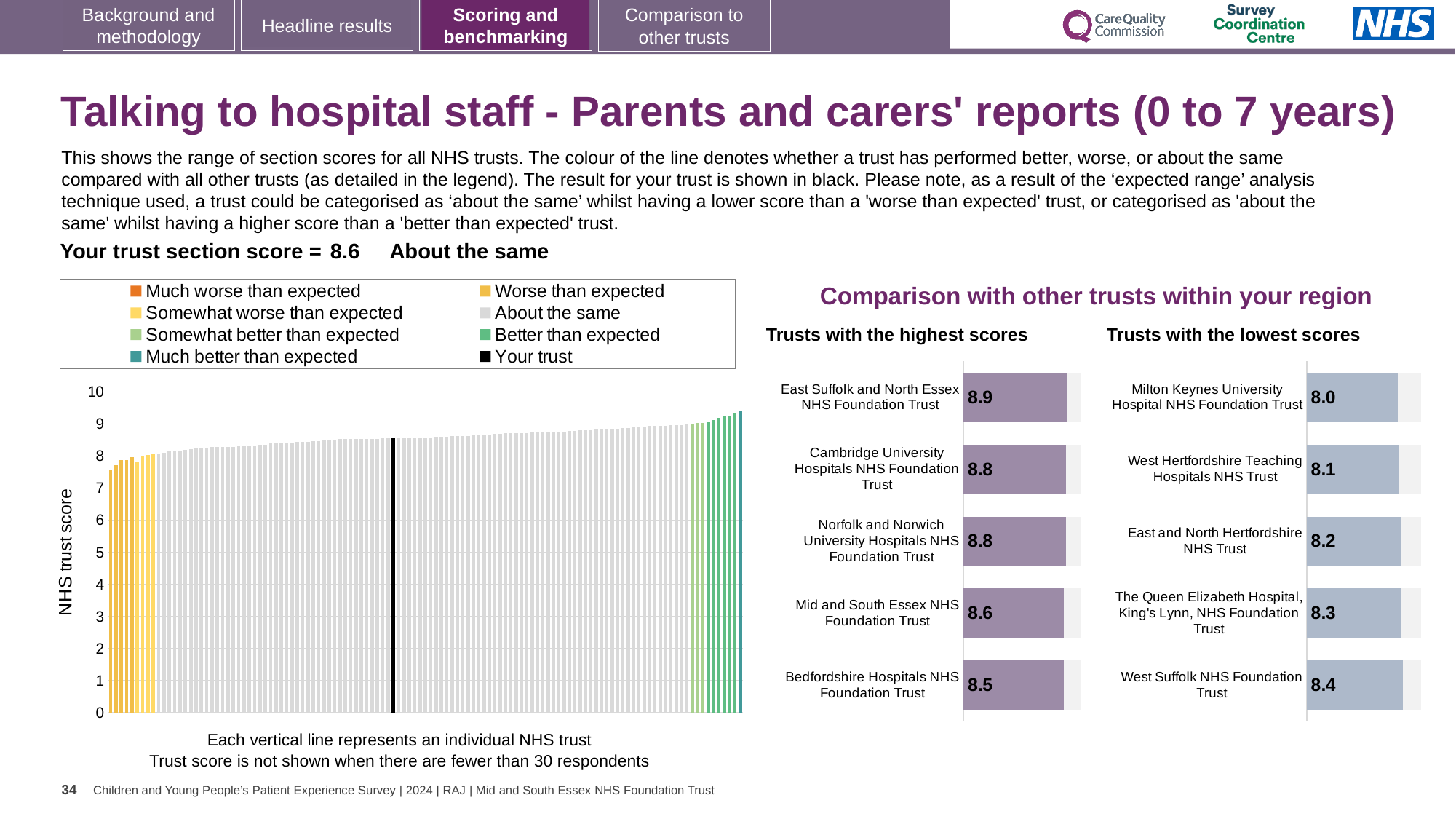
In the 'Trusts with the lowest scores' chart, what is the score for Milton Keynes University Hospital NHS Foundation Trust? 8.0 In the 'NHS trust score' chart on the left, is the value of the leftmost (lowest) bar greater or less than 8? less In the 'Trusts with the lowest scores' chart, which has the larger score: West Suffolk NHS Foundation Trust or East and North Hertfordshire NHS Trust? West Suffolk NHS Foundation Trust In the 'Trusts with the lowest scores' chart, which trust has the lowest score? Milton Keynes University Hospital NHS Foundation Trust In the 'Trusts with the highest scores' chart, which trust has the highest score? East Suffolk and North Essex NHS Foundation Trust In the 'Trusts with the lowest scores' chart, what is the score for West Hertfordshire Teaching Hospitals NHS Trust? 8.1 How many trusts are shown in the 'Trusts with the highest scores' chart? 5 In the 'Trusts with the highest scores' chart, what is the difference between the scores of East Suffolk and North Essex NHS Foundation Trust and Bedfordshire Hospitals NHS Foundation Trust? 0.4 How many entries does the legend above the 'NHS trust score' chart list? 8 In the 'Trusts with the highest scores' chart, what is the score for East Suffolk and North Essex NHS Foundation Trust? 8.9 In the 'NHS trust score' chart on the left, do the bar values rise or fall from left to right along the x axis? Rise What kind of chart is the large 'NHS trust score' chart on the left of the slide? Bar chart